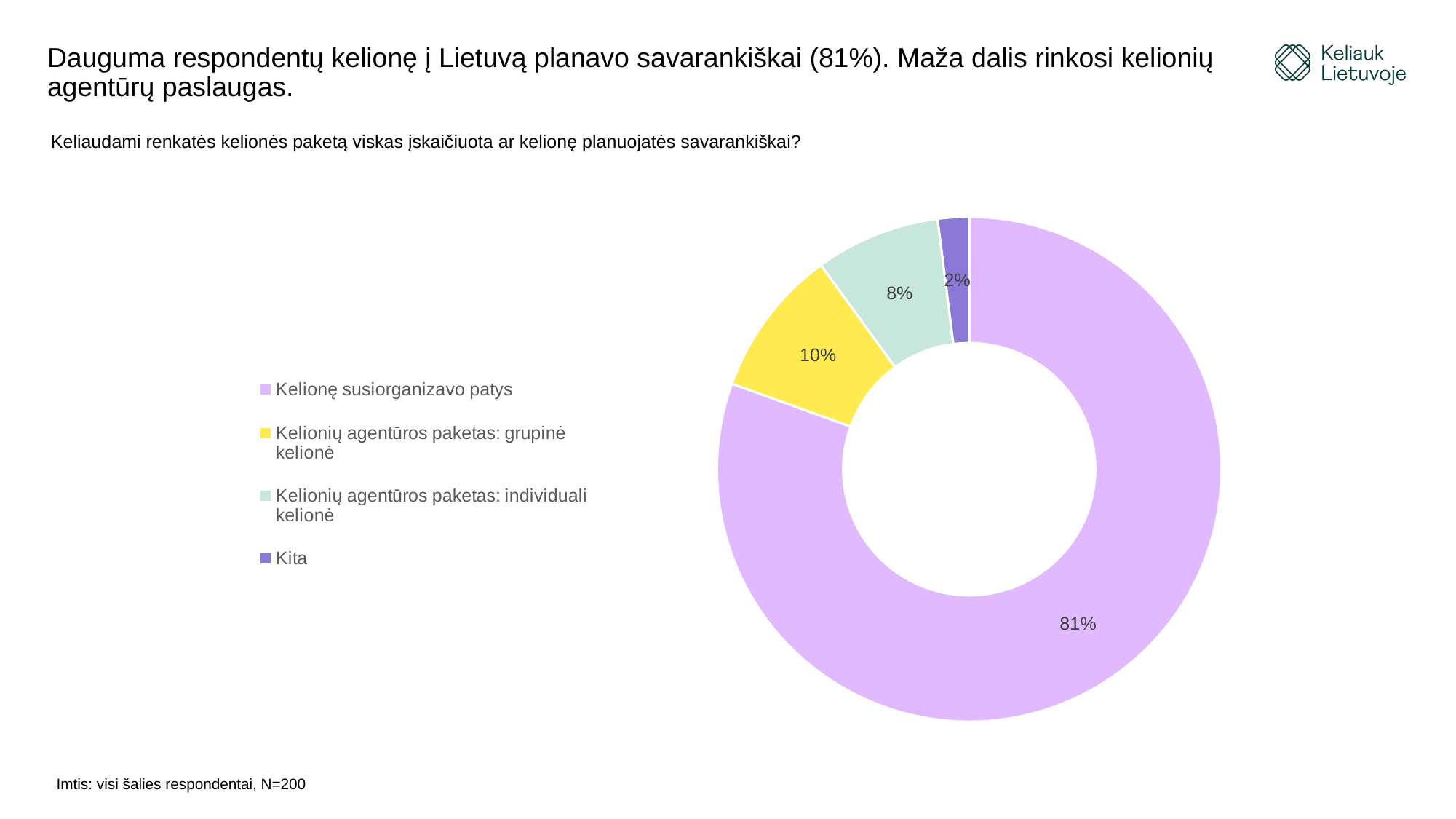
What share of respondents chose "Kelionę susiorganizavo patys"? 81% Which is larger: the share for "Kelionių agentūros paketas: grupinė kelionė" or for "Kelionių agentūros paketas: individuali kelionė"? Kelionių agentūros paketas: grupinė kelionė Which category has the largest share of the pie? Kelionę susiorganizavo patys What colour represents "Kelionių agentūros paketas: grupinė kelionė" in the chart? Yellow What kind of chart is shown on the slide? Pie chart (donut) What is the sample size stated on the slide? N=200 How many categories are shown in the chart? 4 Which category has the smallest share of the pie? Kita What is the difference in percentage points between "Kelionę susiorganizavo patys" and "Kelionių agentūros paketas: grupinė kelionė"? 71 percentage points What share of respondents chose "Kelionių agentūros paketas: grupinė kelionė"? 10% What share of respondents chose "Kita"? 2% What share of respondents chose "Kelionių agentūros paketas: individuali kelionė"? 8%